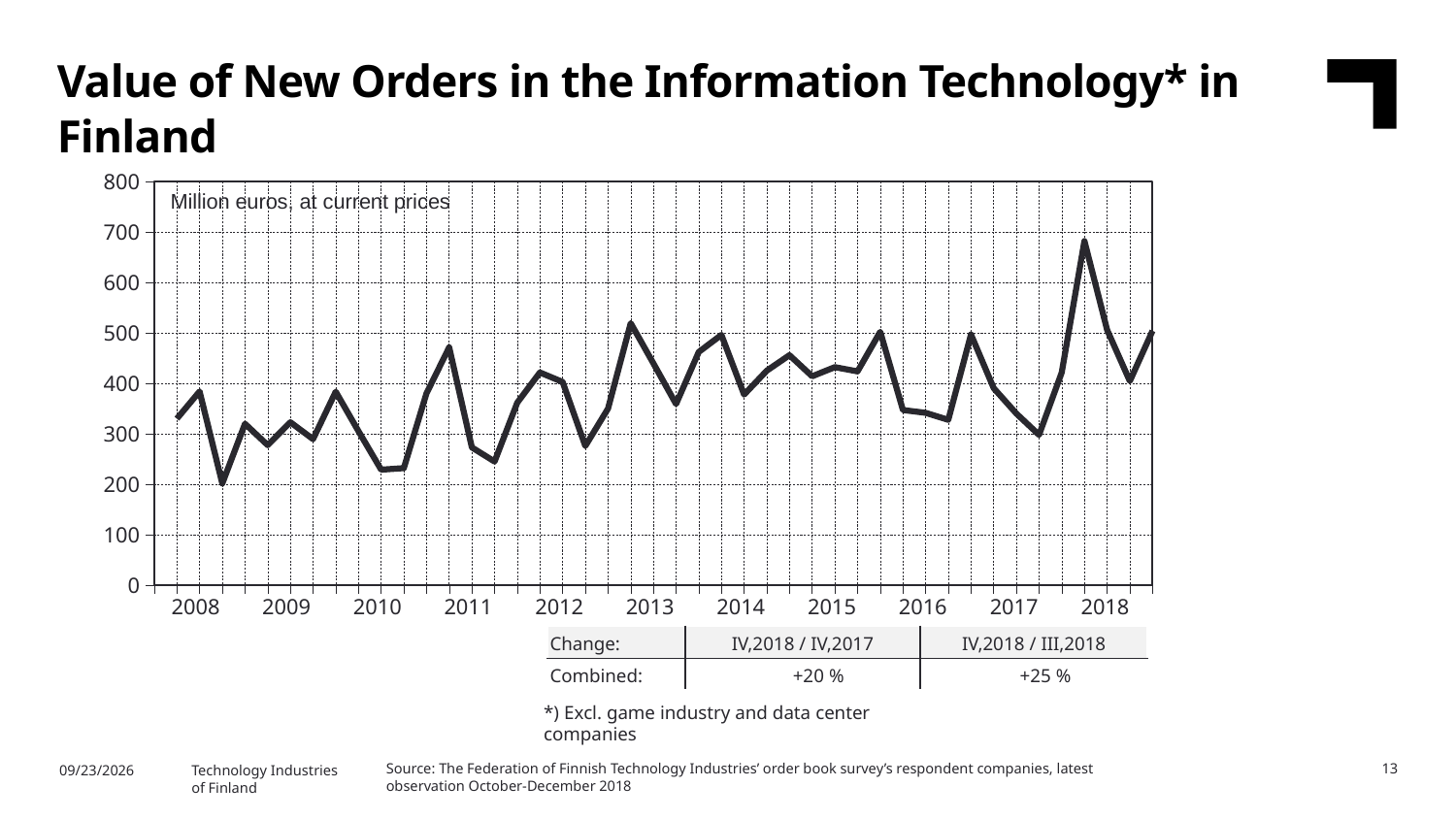
In which year does the line reach its lowest point? 2008 Is the lowest point of the line greater or less than 300? less What is the change for IV,2018 / III,2018 shown in the table below the chart? +25 % What is the highest value shown on the y axis? 800 In which year does the line reach its highest point? 2018 Is the highest point of the line greater or less than 600? greater What is the change for IV,2018 / IV,2017 shown in the table below the chart? +20 % What is the title of the chart? Value of New Orders in the Information Technology* in Finland How many years are labelled on the x axis? 11 Is the last value plotted, at the end of 2018, greater or less than 400? greater What unit is stated inside the chart area? Million euros, at current prices What kind of chart is shown on the slide? line chart